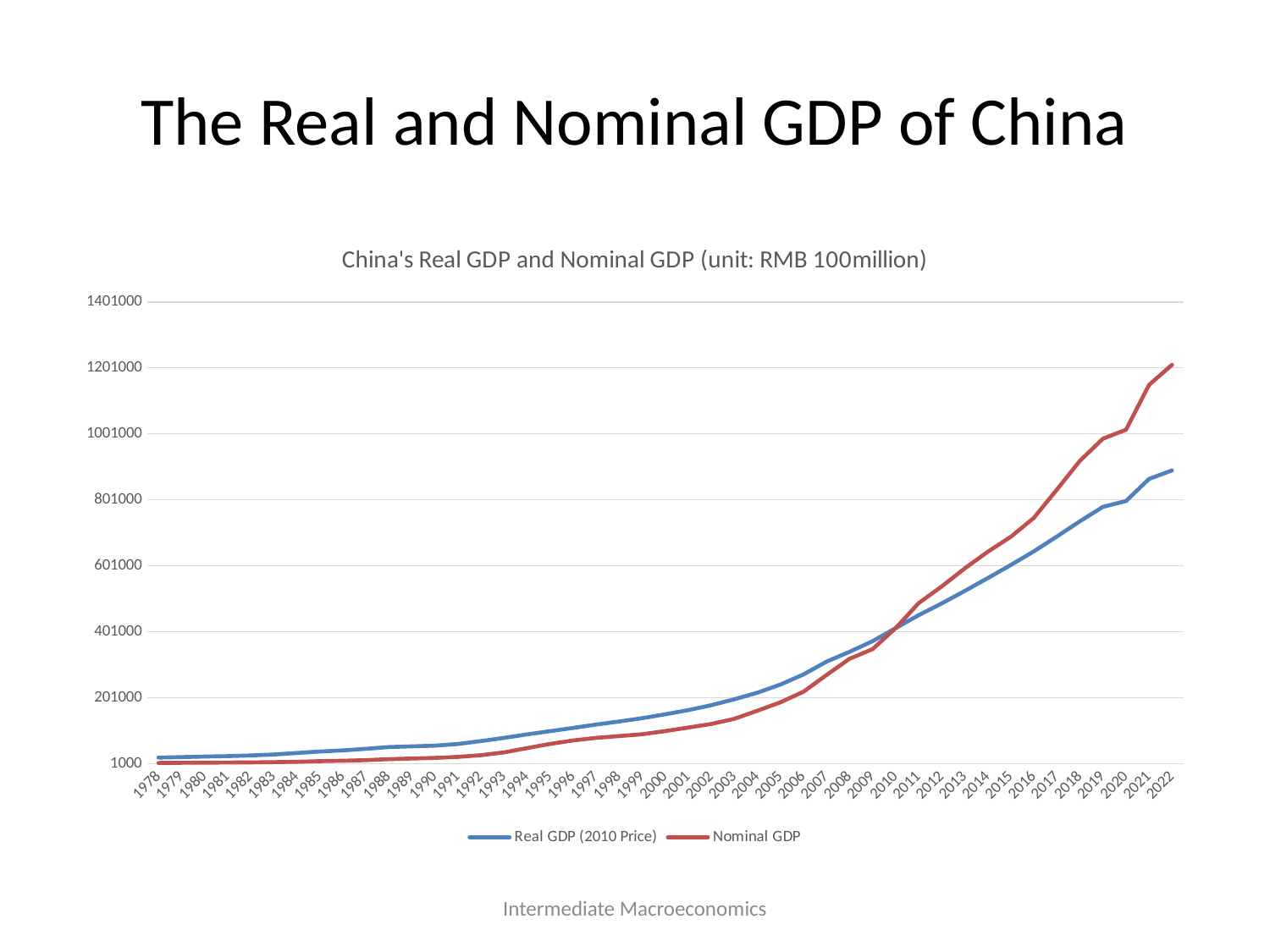
How many series does the legend list? 2 In 2022, which series has the larger value, Real GDP (2010 Price) or Nominal GDP? Nominal GDP Is the value for Nominal GDP in 2018 greater or less than 801000? greater What kind of chart is shown on the slide? line chart Do the values for Nominal GDP rise or fall from 1978 to 2022? rise Is the value for Nominal GDP in 2022 greater or less than 1001000? greater What is the title of the chart? China's Real GDP and Nominal GDP (unit: RMB 100million) Is the value for Real GDP (2010 Price) in 2022 greater or less than 1001000? less How many years are plotted along the x axis? 45 In 2000, which series has the larger value, Real GDP (2010 Price) or Nominal GDP? Real GDP (2010 Price)